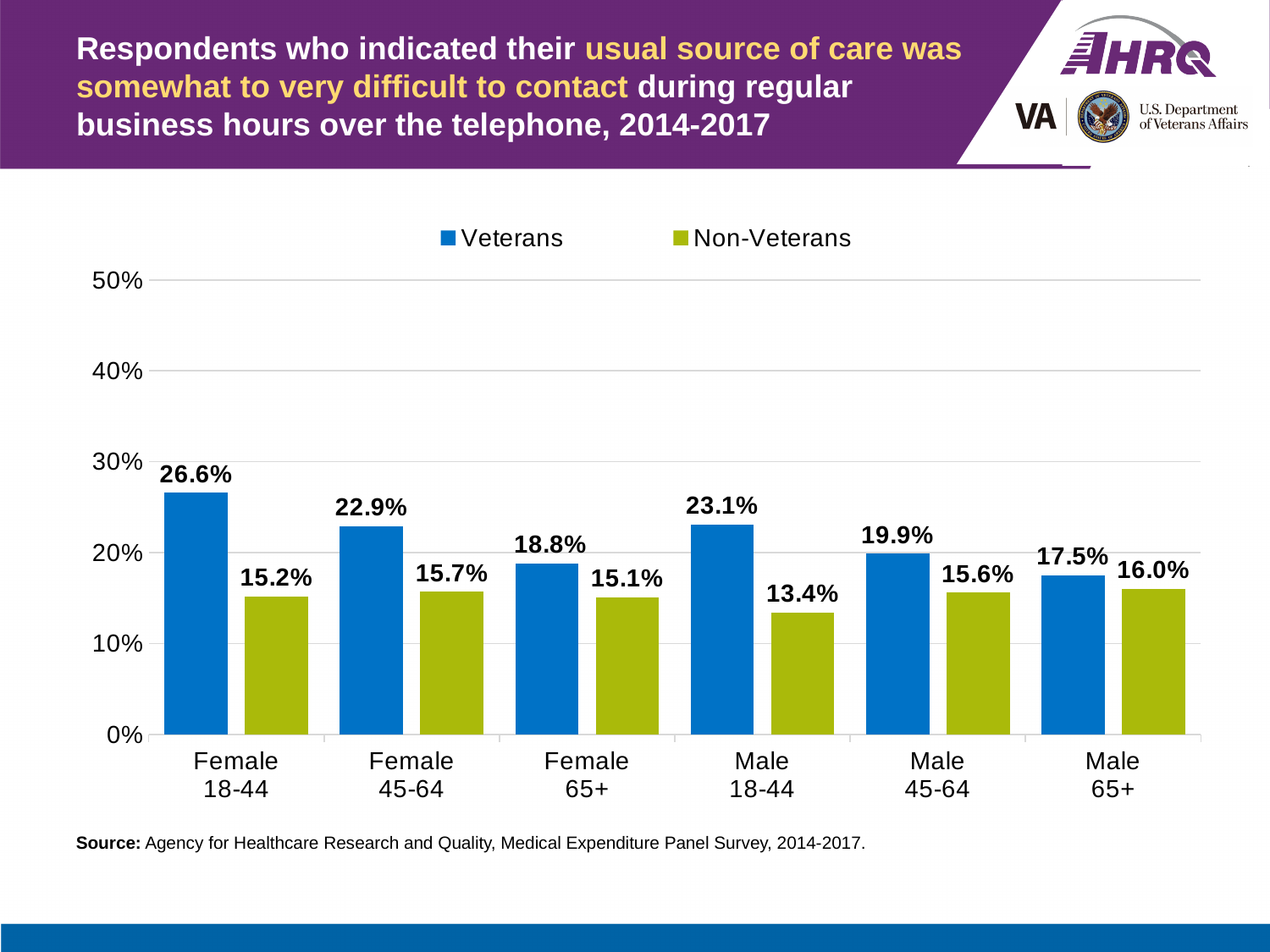
What is the value for Non-Veterans in the Male 18-44 category? 13.4% Which is larger in the Male 45-64 category: the Veterans value or the Non-Veterans value? Veterans What is the difference between the Veterans and Non-Veterans values in the Female 18-44 category? 11.4% Is the value for Veterans in the Male 18-44 category greater or less than 20%? greater What is the value for Veterans in the Male 65+ category? 17.5% How many series does the legend list? 2 Which category has the highest value for Veterans? Female 18-44 How many categories are shown on the x axis? 6 What is the value for Veterans in the Female 18-44 category? 26.6% Which series is shown in green in the legend? Non-Veterans Which category has the lowest value for Non-Veterans? Male 18-44 What kind of chart is shown on the slide? Bar chart